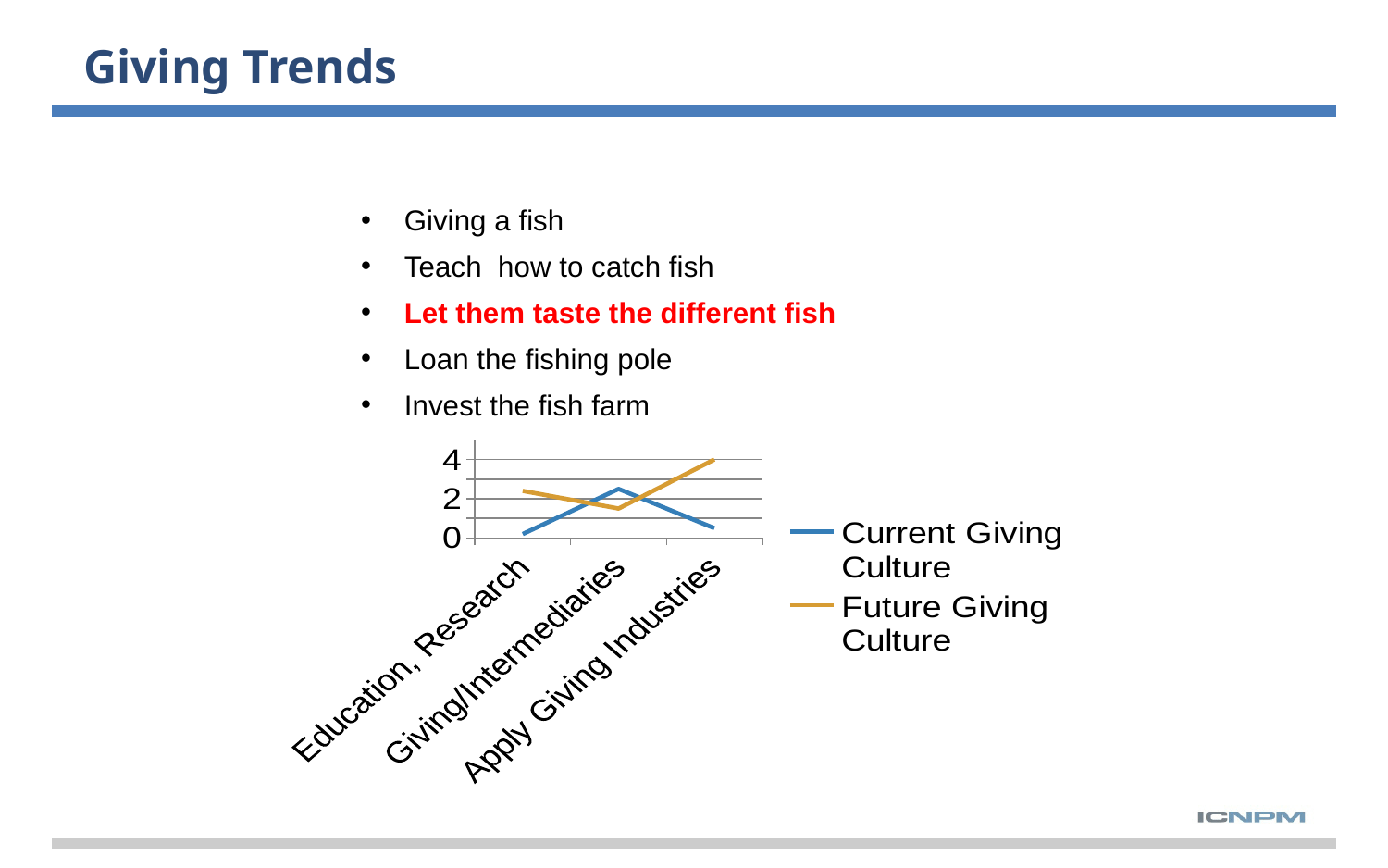
At Apply Giving Industries, which series has the higher value, Current Giving Culture or Future Giving Culture? Future Giving Culture Is the Future Giving Culture value for Apply Giving Industries greater or less than 2? greater What kind of chart is shown on the slide? line chart How many series does the chart's legend list? 2 At Giving/Intermediaries, which series has the higher value, Current Giving Culture or Future Giving Culture? Current Giving Culture What are the two series named in the chart's legend? Current Giving Culture and Future Giving Culture For which category is the Future Giving Culture line at its highest? Apply Giving Industries For which category is the Current Giving Culture line at its highest? Giving/Intermediaries For which category is the Future Giving Culture line at its lowest? Giving/Intermediaries At Education, Research, which series has the higher value, Current Giving Culture or Future Giving Culture? Future Giving Culture Is the Current Giving Culture value for Education, Research greater or less than 2? less How many categories are shown on the x axis of the chart? 3